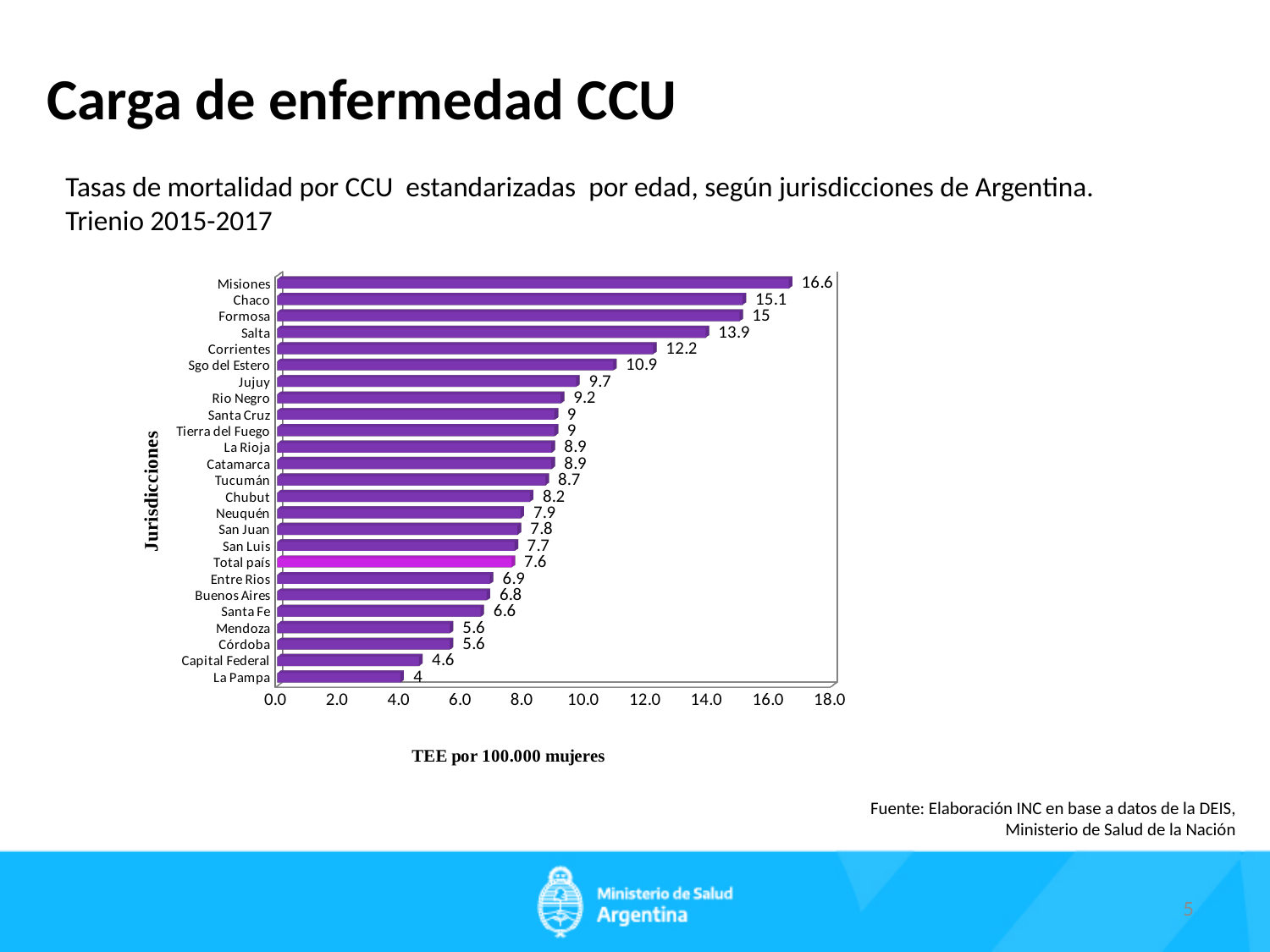
What is the difference between the values for Misiones and La Pampa? 12.6 What is the label of the horizontal axis? TEE por 100.000 mujeres How many jurisdictions (bars) are shown in the chart? 25 What kind of chart is shown on the slide? Bar chart Which jurisdiction has the lowest value? La Pampa Which has a larger value, Corrientes or Jujuy? Corrientes What is the value for Capital Federal? 4.6 Which jurisdiction has the highest value? Misiones What is the difference between the values for Chaco and Salta? 1.2 Is the value for Sgo del Estero greater or less than 10.0? greater What is the value for Misiones? 16.6 What is the value for Total país? 7.6